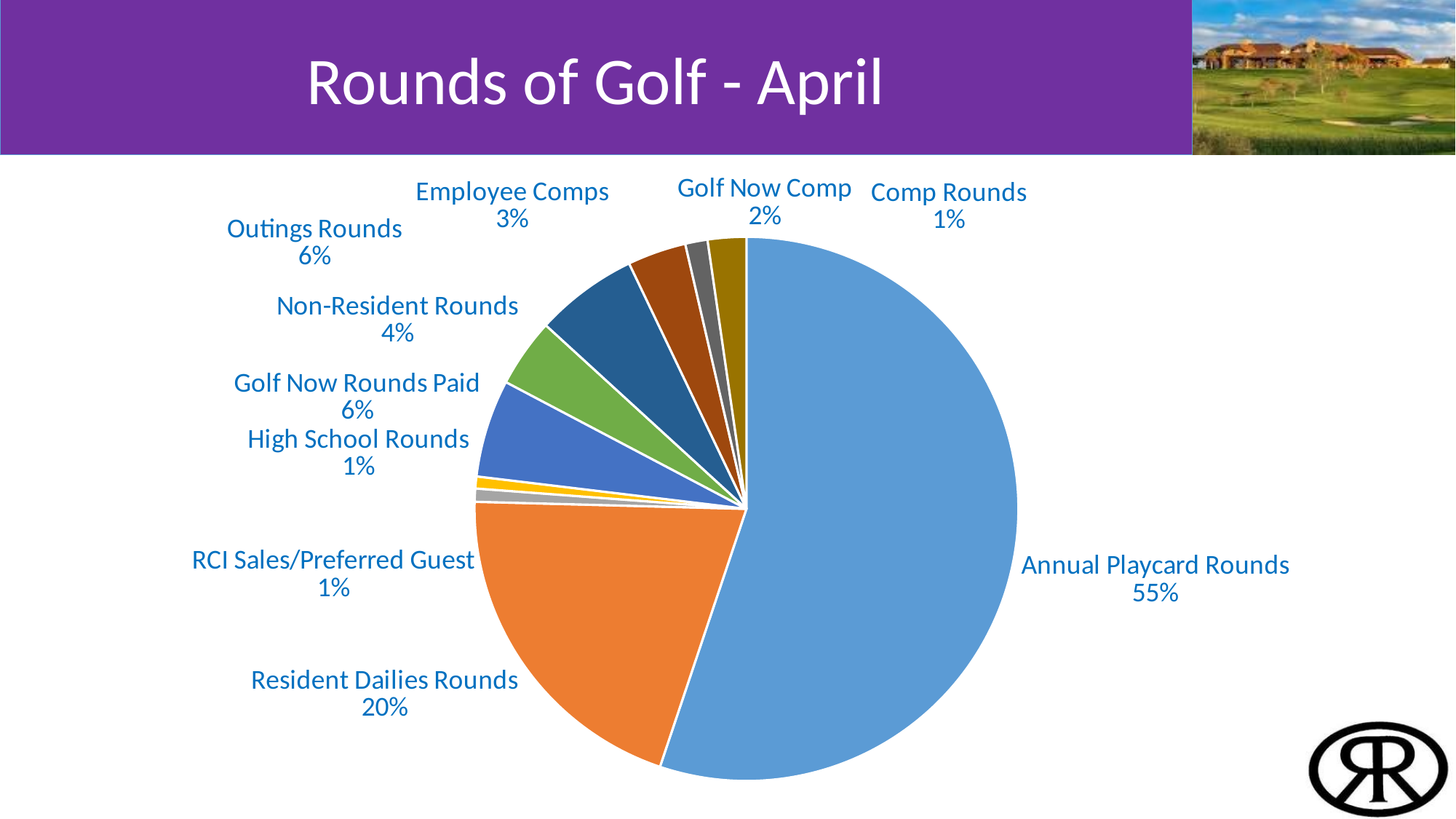
What percentage is shown for Golf Now Rounds Paid? 6% What is the title of the slide containing the chart? Rounds of Golf - April Which category has the largest slice of the pie? Annual Playcard Rounds What percentage is shown for Employee Comps? 3% Which is larger, Outings Rounds or Non-Resident Rounds? Outings Rounds What percentage is shown for Golf Now Comp? 2% What share of rounds is Resident Dailies Rounds? 20% What kind of chart is shown on the slide? pie chart What is the difference in percentage points between Annual Playcard Rounds and Resident Dailies Rounds? 35 What share of rounds is Annual Playcard Rounds? 55% What percentage is shown for Non-Resident Rounds? 4% How many categories are shown in the pie chart? 10